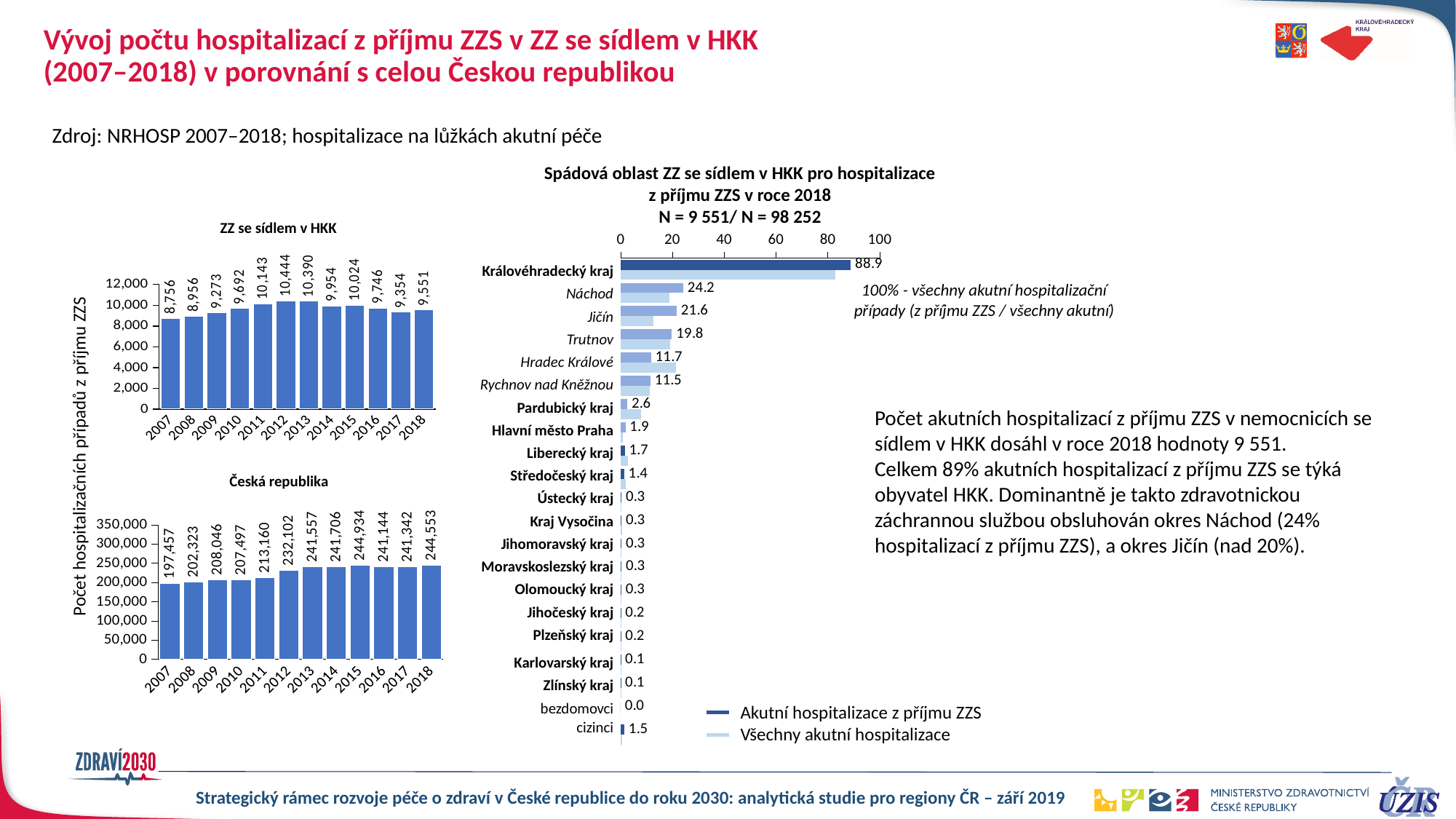
In the 'Spádová oblast ZZ se sídlem v HKK' chart, which category has the highest value in the 'Akutní hospitalizace z příjmu ZZS' series? Královéhradecký kraj In the 'ZZ se sídlem v HKK' chart, which year has the highest value? 2012 In the 'Česká republika' chart, how many years are plotted? 12 How many series does the legend of the 'Spádová oblast ZZ se sídlem v HKK' chart list? 2 In the 'Česká republika' chart, which year has the highest value? 2015 In the 'ZZ se sídlem v HKK' chart, which year has the lowest value? 2007 In the 'Česká republika' chart, is the value for 2011 larger or smaller than the value for 2013? smaller In the 'Spádová oblast ZZ se sídlem v HKK' chart, what is the value for Náchod in the 'Akutní hospitalizace z příjmu ZZS' series? 24.2 In the 'ZZ se sídlem v HKK' chart, what is the value for 2018? 9,551 What kind of chart is the 'Spádová oblast ZZ se sídlem v HKK' chart? bar chart In the 'ZZ se sídlem v HKK' chart, what is the difference between the values for 2012 and 2007? 1,688 In the 'Česká republika' chart, what is the value for 2012? 232,102